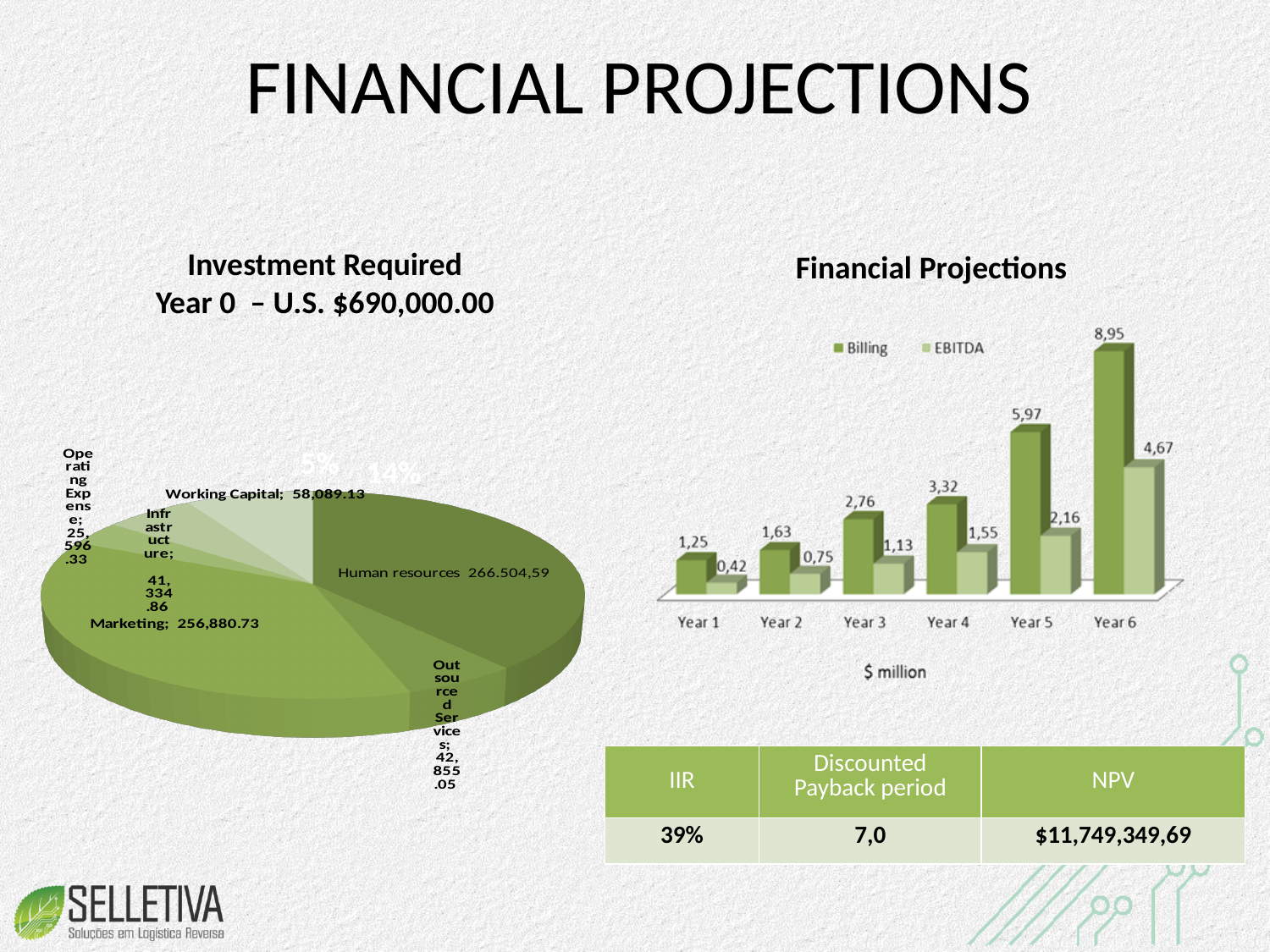
In the Financial Projections chart, how many series does the legend list? 2 In the Financial Projections chart, what is the EBITDA value for Year 3? 1,13 In the Financial Projections chart, what is the difference between the Billing values for Year 6 and Year 5? 2,98 In the Financial Projections chart, is the Billing value for Year 4 larger or the EBITDA value for Year 6? EBITDA for Year 6 What kind of chart is the Investment Required chart on the left? pie chart In the Financial Projections chart, how many years are shown on the x axis? 6 In the Investment Required pie chart, what is the value for Marketing? 256,880.73 In the Financial Projections chart, do the Billing values rise or fall from Year 1 to Year 6? rise In the Financial Projections chart, what is the Billing value for Year 6? 8,95 In the Investment Required pie chart, which category has the smallest value? Operating Expense In the Financial Projections chart, which year has the highest EBITDA value? Year 6 In the Financial Projections chart, which year has the lowest Billing value? Year 1